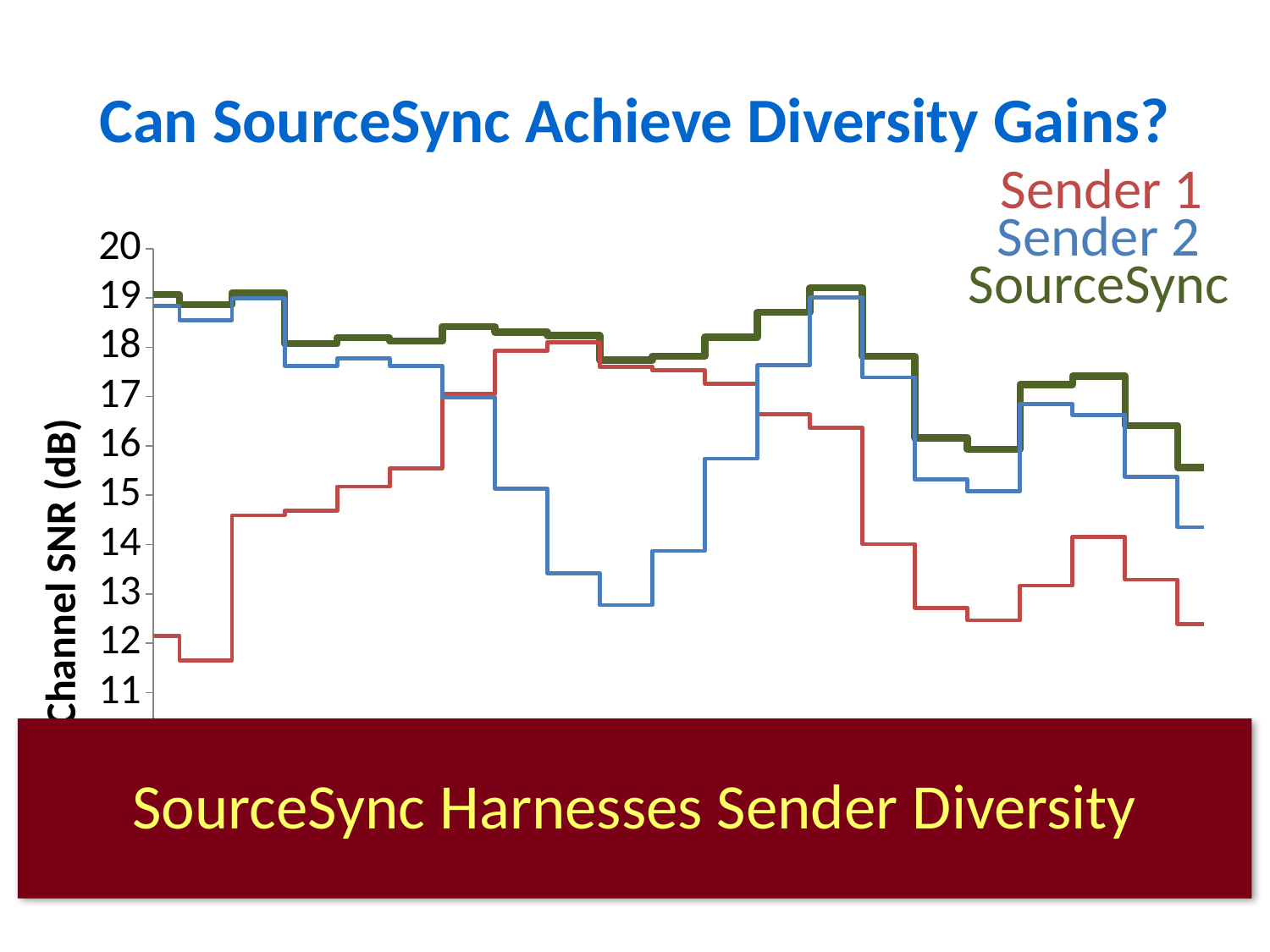
Is the highest value reached by the Sender 1 line greater or less than 19? less At the right edge of the chart, which is larger, the Sender 2 value or the Sender 1 value? Sender 2 What kind of chart is shown on the slide? Line chart Which series stays at or above the other two across the whole chart? SourceSync Is the lowest value reached by the SourceSync line greater or less than 15? greater How many series does the legend list? 3 What is the label of the vertical axis? Channel SNR (dB) Is the lowest value reached by the Sender 2 line greater or less than 13? less What is the title of the chart on the slide? Can SourceSync Achieve Diversity Gains? Which series drops to the lowest value anywhere on the chart? Sender 1 What is the highest tick value shown on the vertical axis? 20